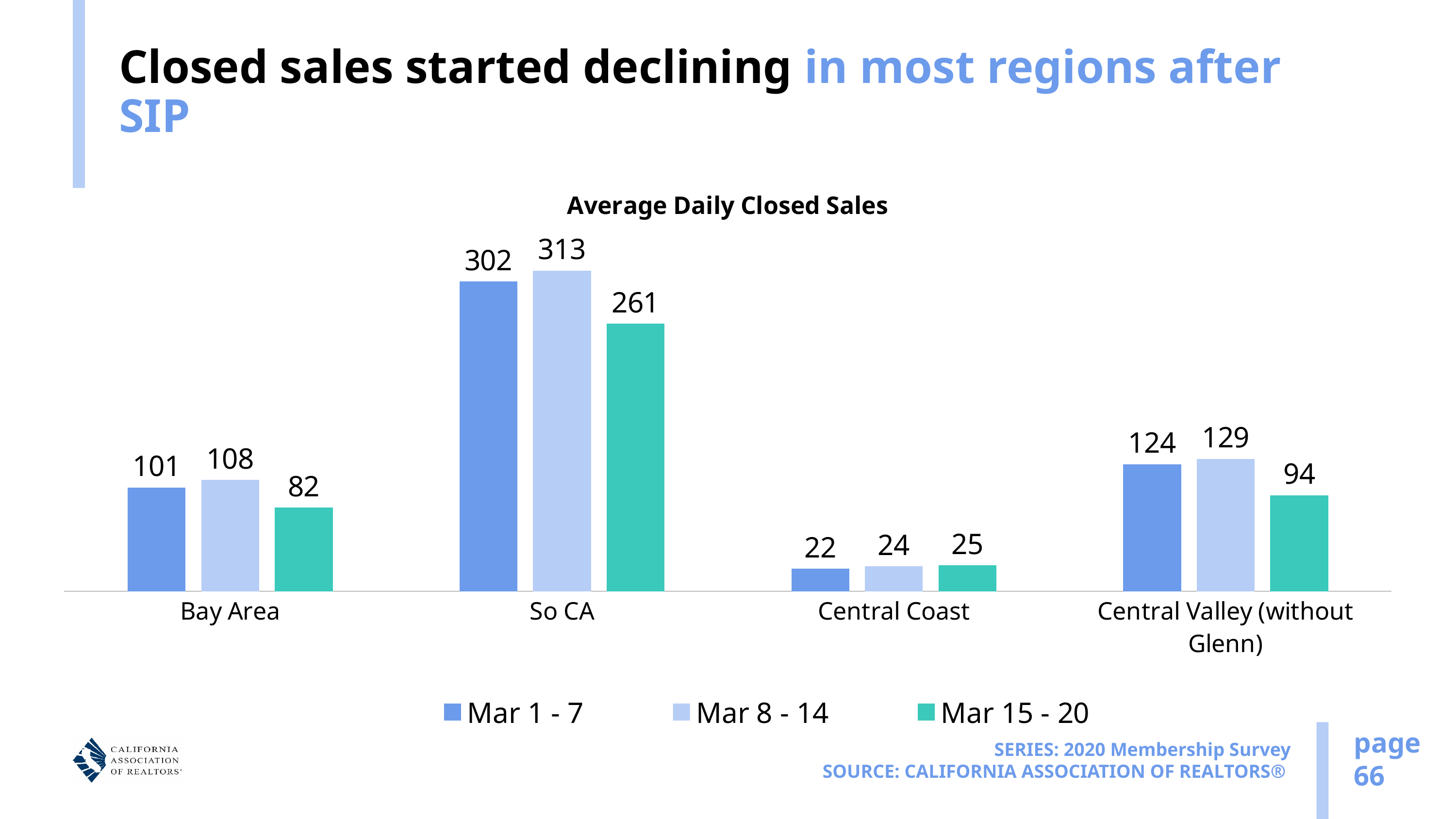
What is the difference between Bay Area's Mar 1 - 7 and Mar 15 - 20 values? 19 What is the value for Central Coast in Mar 15 - 20? 25 Which region has the highest average daily closed sales in Mar 1 - 7? So CA How many regions are shown on the x axis? 4 What is the average daily closed sales for So CA in Mar 8 - 14? 313 Which region has the lowest average daily closed sales in Mar 8 - 14? Central Coast What is the average daily closed sales for Bay Area in Mar 15 - 20? 82 Which is larger: Central Valley (without Glenn) in Mar 15 - 20 or Bay Area in Mar 15 - 20? Central Valley (without Glenn) What type of chart is shown on the slide? Bar chart How many series does the legend list? 3 What is the value for Central Valley (without Glenn) in Mar 1 - 7? 124 What is the difference between So CA's Mar 8 - 14 and Mar 15 - 20 values? 52